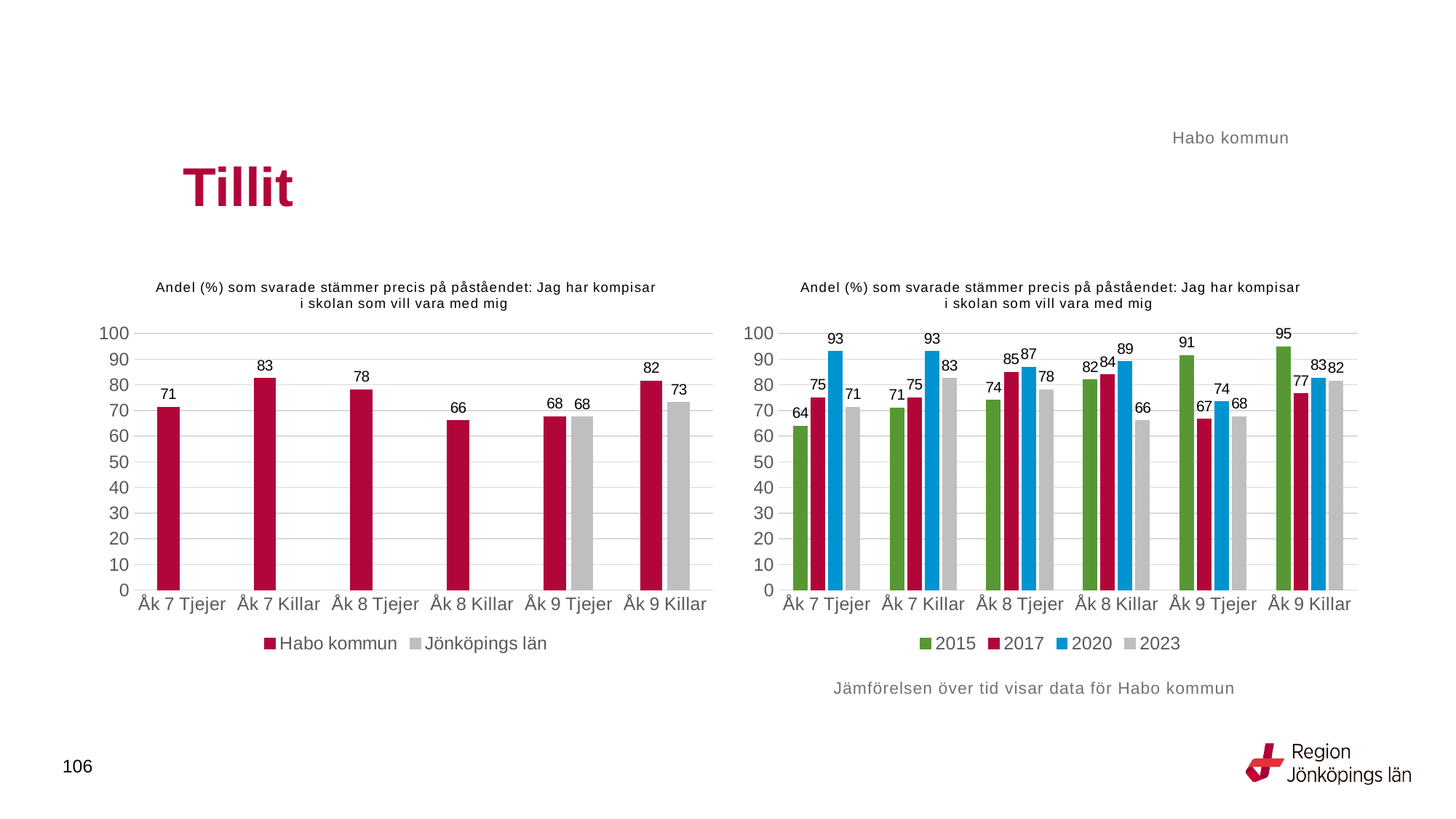
In the right chart, what is the value for 2015 for Åk 7 Tjejer? 64 In the left chart, what is the difference between Habo kommun and Jönköpings län for Åk 9 Killar? 9 In the left chart, which category has the lowest value for Habo kommun? Åk 8 Killar What kind of chart is the right chart? Bar chart In the left chart, what is the value for Jönköpings län for Åk 9 Killar? 73 In the right chart, which category has the highest value for 2015? Åk 9 Killar In the left chart, how many series does the legend list? 2 In the right chart, what is the value for 2020 for Åk 8 Killar? 89 In the right chart, which is larger for Åk 9 Tjejer: the 2015 value or the 2017 value? 2015 In the left chart, what is the value for Habo kommun for Åk 7 Killar? 83 In the right chart, how many series does the legend list? 4 In the right chart, what is the difference between the 2020 and 2023 values for Åk 8 Killar? 23